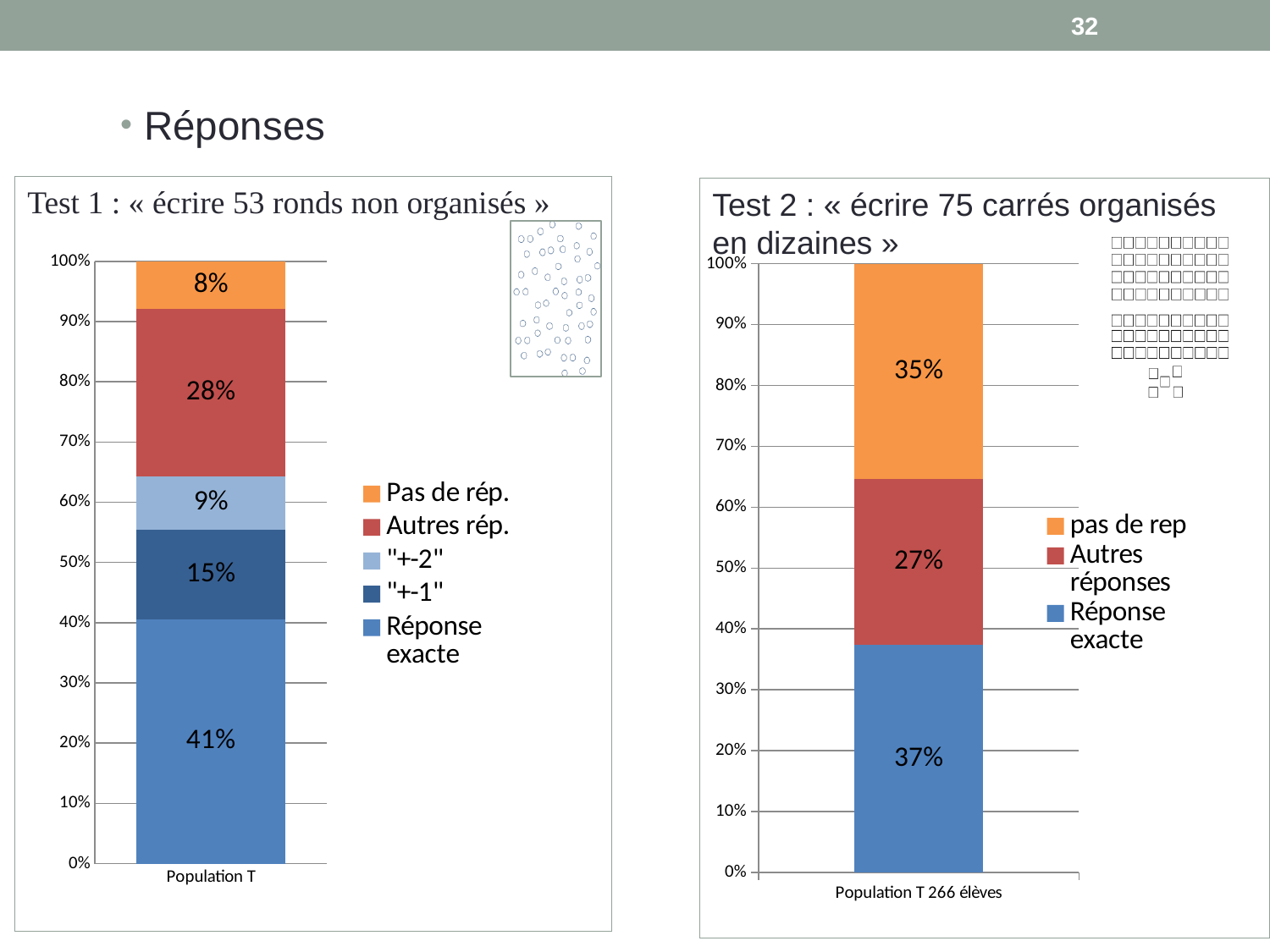
In the Test 1 chart, how many series does the legend list? 5 In the Test 1 chart, what is the value for "Réponse exacte"? 41% In the Test 1 chart, what is the difference between "Réponse exacte" and "Autres rép."? 13% In the Test 2 chart, what is the value for "pas de rep"? 35% In the Test 2 chart, what is the value for "Réponse exacte"? 37% In the Test 1 chart, what is the value for "Autres rép."? 28% In the Test 2 chart, what is the difference between "pas de rep" and "Autres réponses"? 8% In the Test 1 chart, what is the value for "+-1"? 15% What kind of chart is the Test 2 chart? Stacked bar chart In the Test 1 chart, which series has the smallest value? Pas de rép. In the Test 2 chart, how many series does the legend list? 3 In the Test 2 chart, which series has the smallest value? Autres réponses